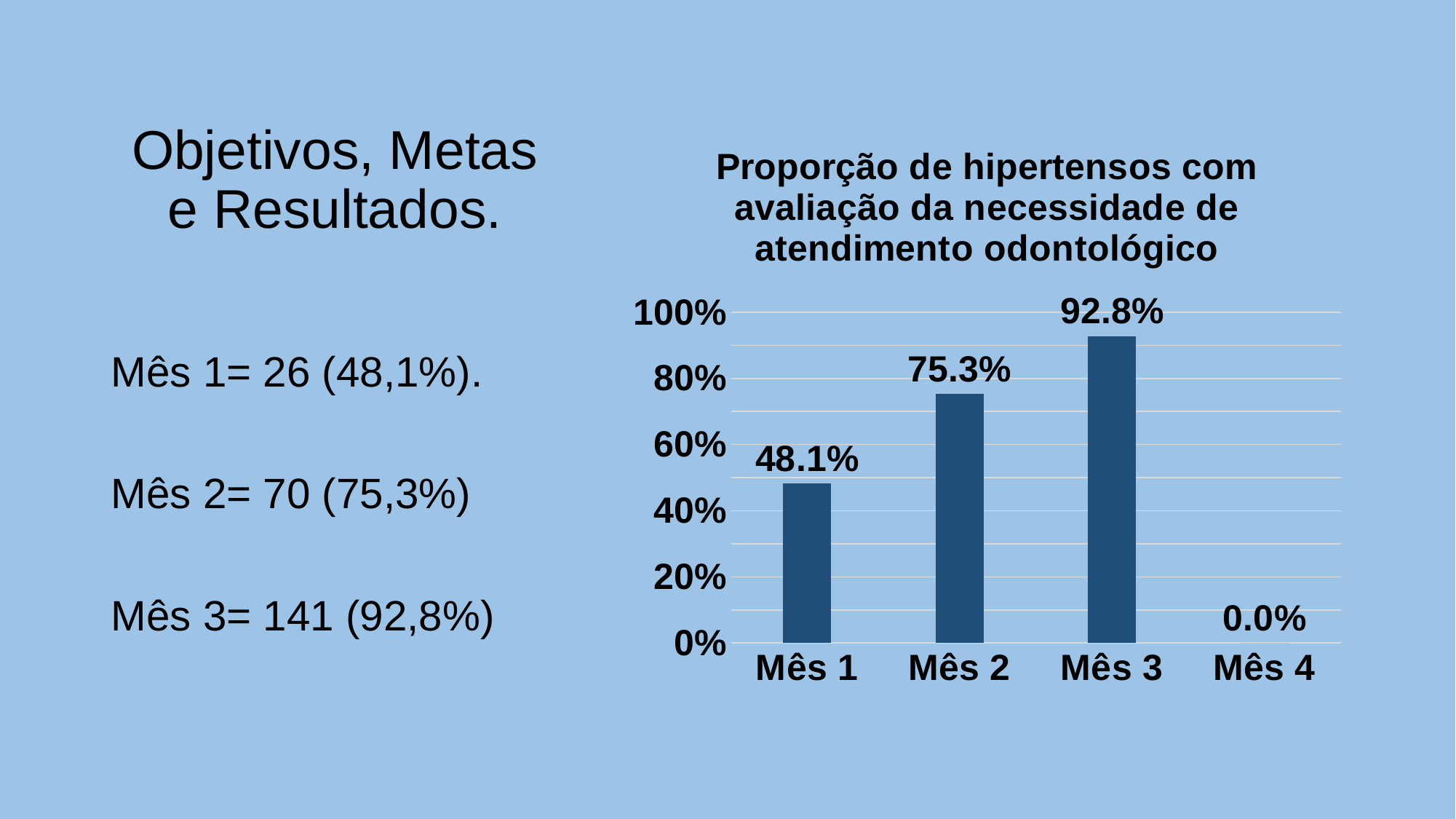
Which category has the lowest value? Mês 4 What is the value for Mês 2? 75.3% What is the value for Mês 1? 48.1% What is the value for Mês 3? 92.8% What is the difference between the values for Mês 2 and Mês 1? 27.2% What is the title of the chart? Proporção de hipertensos com avaliação da necessidade de atendimento odontológico What kind of chart is shown on the slide? bar chart Which is larger, the value for Mês 1 or the value for Mês 2? Mês 2 What is the value for Mês 4? 0.0% How many categories are shown on the x axis? 4 Which category has the highest value? Mês 3 What is the difference between the values for Mês 3 and Mês 2? 17.5%